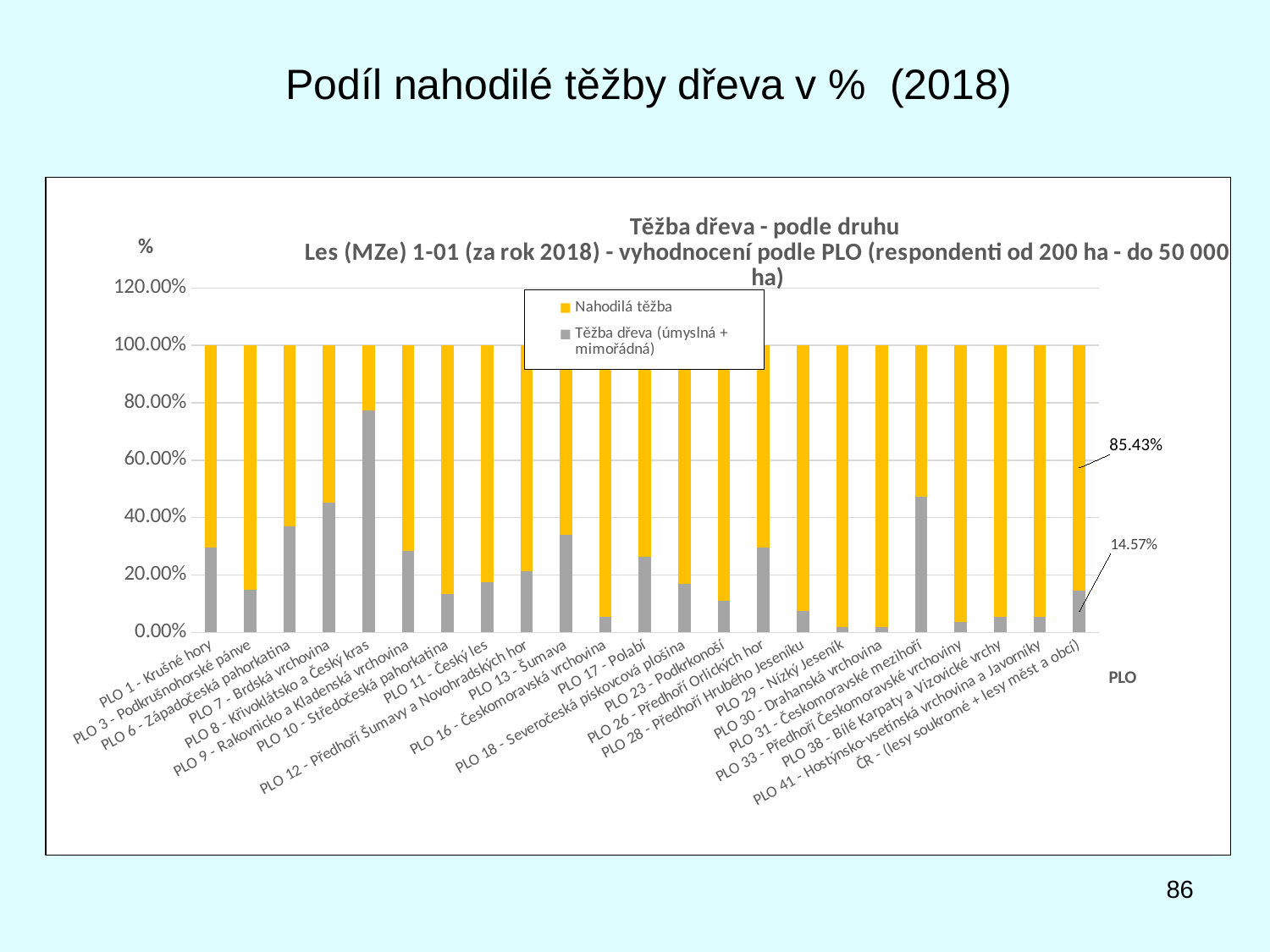
Which has a larger share of Těžba dřeva (úmyslná + mimořádná): PLO 7 - Brdská vrchovina or PLO 3 - Podkrušnohorské pánve? PLO 7 - Brdská vrchovina Is the share of Těžba dřeva (úmyslná + mimořádná) for PLO 1 - Krušné hory greater or less than 40.00%? less What is the labelled value of Nahodilá těžba for ČR - (lesy soukromé + lesy měst a obcí)? 85.43% Is the share of Těžba dřeva (úmyslná + mimořádná) for PLO 8 - Křivoklátsko a Český kras greater or less than 60.00%? greater What is the labelled value of Těžba dřeva (úmyslná + mimořádná) for ČR - (lesy soukromé + lesy měst a obcí)? 14.57% What is the difference between the two labelled values for ČR - (lesy soukromé + lesy měst a obcí)? 70.86% How many series does the legend list? 2 What are the two series named in the legend? Nahodilá těžba; Těžba dřeva (úmyslná + mimořádná) What kind of chart is shown on the slide? Stacked bar chart How many PLO categories are plotted along the x axis? 23 Which PLO has the smallest share of Nahodilá těžba? PLO 8 - Křivoklátsko a Český kras Which PLO has the largest share of Těžba dřeva (úmyslná + mimořádná)? PLO 8 - Křivoklátsko a Český kras